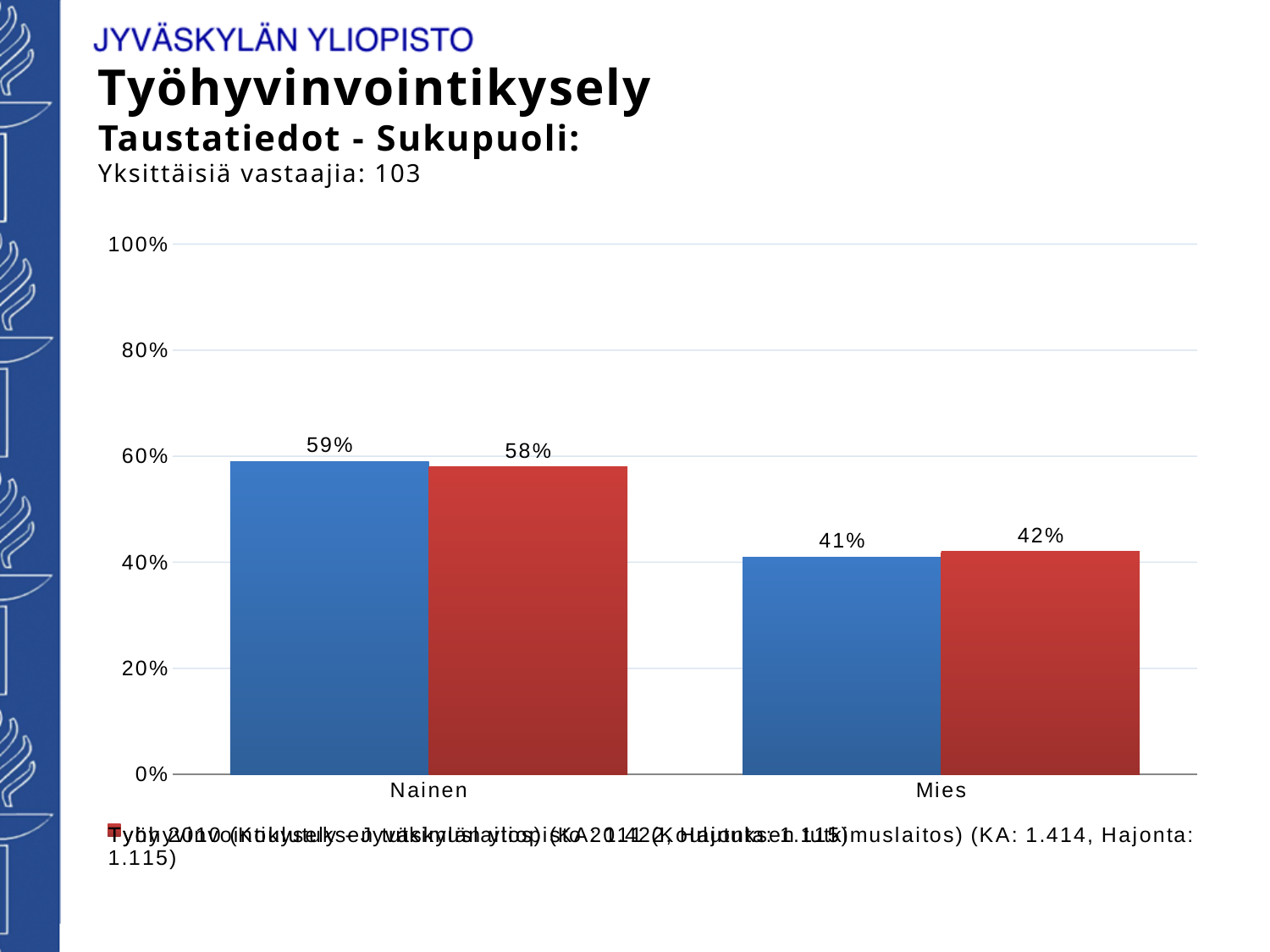
Which category has the lowest red bar? Mies What kind of chart is shown on the slide? bar chart What is the value of the blue bar for Nainen? 59% Is the blue bar for Nainen greater or less than 40%? greater What is the difference between the blue bar for Nainen and the blue bar for Mies? 18% What is the difference between the red bar for Nainen and the red bar for Mies? 16% What is the value of the red bar for Nainen? 58% What is the value of the blue bar for Mies? 41% Which category has the highest blue bar? Nainen What is the value of the red bar for Mies? 42% Which is larger, the red bar for Nainen or the red bar for Mies? Nainen How many categories are shown on the x axis of the chart? 2